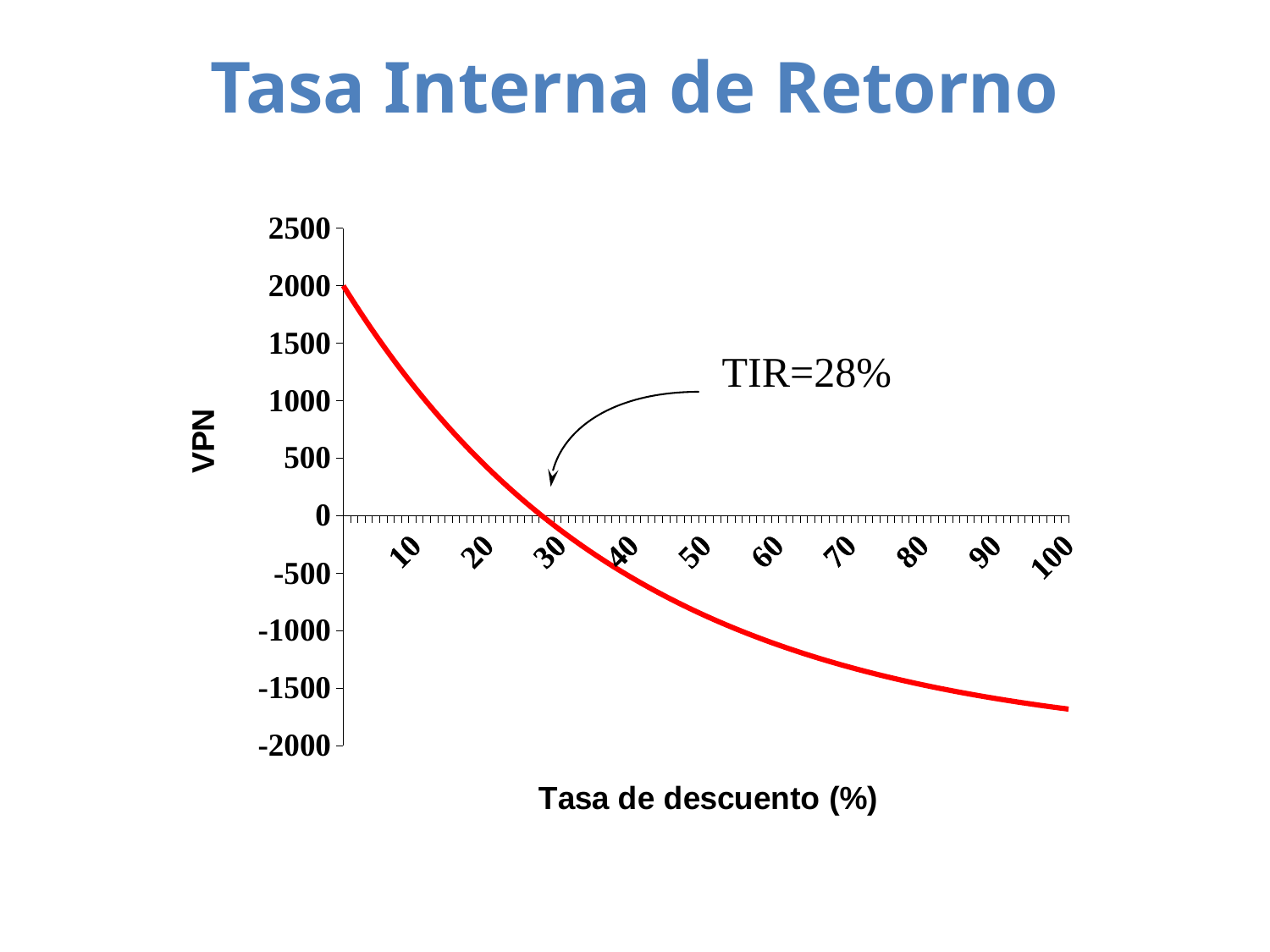
What is the VPN value where the curve starts, at a discount rate of 0%? 2000 What kind of chart is shown on the slide? line chart Is the VPN at a discount rate of 40% greater or less than 0? less How many labelled tick marks are shown on the x axis? 10 What is the title of the x axis? Tasa de descuento (%) According to the annotation on the chart, at what discount rate is the TIR (where VPN equals zero)? 28% Is the VPN at a discount rate of 60% greater or less than -500? less What is the title of the y axis? VPN Which has the higher VPN: a discount rate of 10% or a discount rate of 50%? 10% Is the VPN at a discount rate of 100% greater or less than -1500? less Does the VPN rise or fall as the discount rate (Tasa de descuento) increases? fall